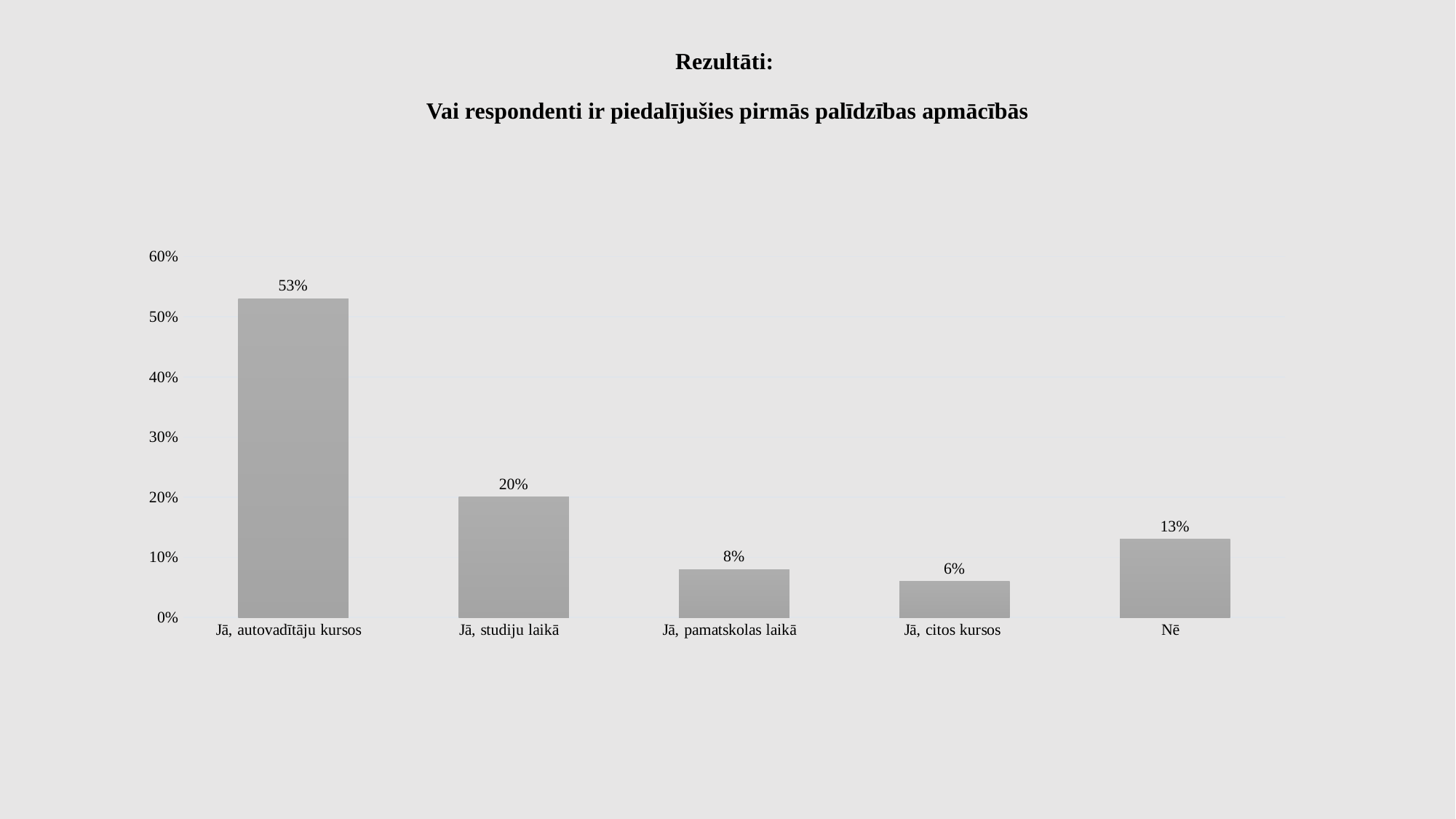
Which category has the lowest value? Jā, citos kursos Which category has the highest value? Jā, autovadītāju kursos Is the value for "Jā, studiju laikā" greater or less than 30%? less What is the value for "Jā, autovadītāju kursos"? 53% What is the title of the chart? Vai respondenti ir piedalījušies pirmās palīdzības apmācībās What is the value for "Jā, citos kursos"? 6% How many categories are shown on the x axis? 5 What is the value for "Jā, studiju laikā"? 20% What is the value for "Nē"? 13% Which is larger, the value for "Nē" or the value for "Jā, pamatskolas laikā"? Nē What is the difference between the values for "Jā, autovadītāju kursos" and "Jā, studiju laikā"? 33% What kind of chart is shown on the slide? bar chart